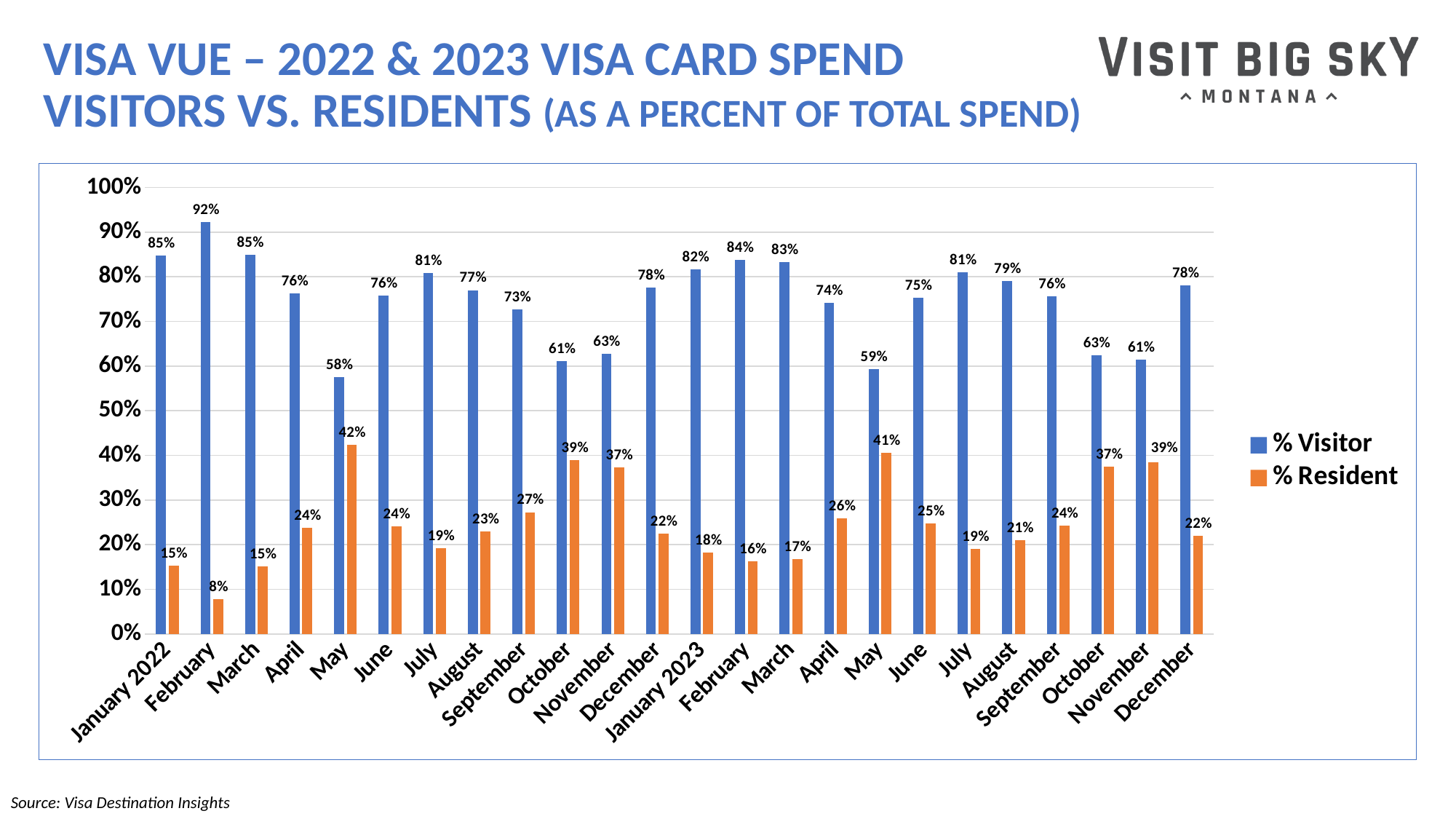
What is the % Resident value for May 2023? 41% What is the % Visitor value for February 2022? 92% Which month has the highest % Visitor value? February 2022 What kind of chart is shown on the slide? Bar chart What colour are the % Resident bars? Orange Is the % Visitor value for May 2022 larger or smaller than the % Visitor value for May 2023? smaller What is the % Visitor value for December 2023? 78% How many series does the legend list? 2 What is the difference between the % Visitor and % Resident values for October 2023? 26% How many months are shown on the x axis? 24 Which month has the highest % Resident value? May 2022 Which month has the lowest % Resident value? February 2022